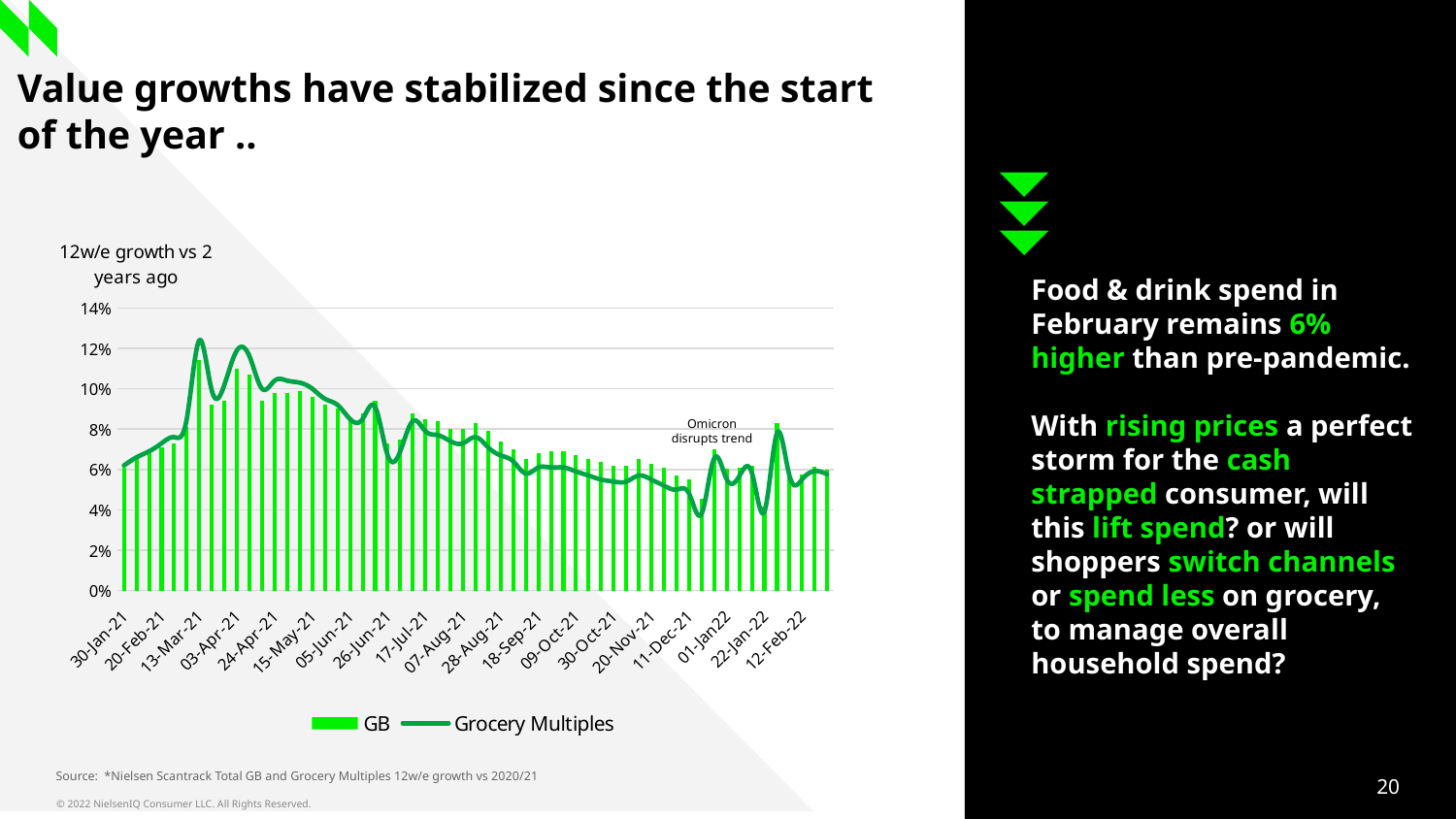
What is the highest value shown on the chart's vertical axis? 14% Is the Grocery Multiples value around 11-Dec-21 greater or less than 6%? less Which is higher, the Grocery Multiples value around 13-Mar-21 or around 11-Dec-21? 13-Mar-21 Overall, do the growth values rise or fall from spring 2021 to early 2022? fall What kind of chart is shown on the slide? A combined bar and line chart Is the Grocery Multiples value around 13-Mar-21 greater or less than 10%? greater Is the GB value at 12-Feb-22 greater or less than 8%? less Which two series are listed in the chart legend? GB and Grocery Multiples Which series is drawn as a line rather than bars? Grocery Multiples How many series does the chart legend list? 2 How many date labels are shown along the x axis? 19